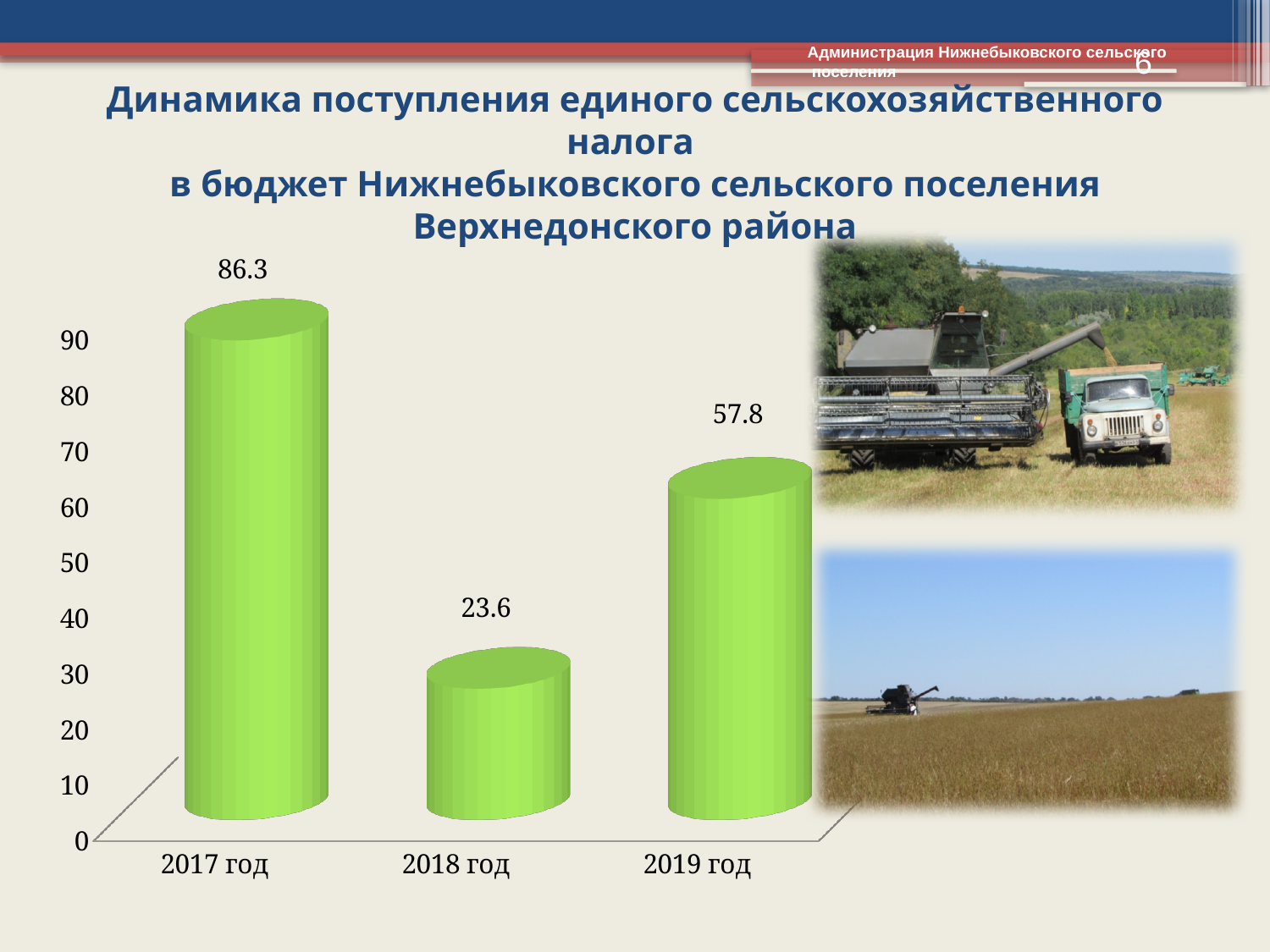
What kind of chart is shown on the slide? bar chart Which year has the highest value? 2017 год What is the value for 2019 год? 57.8 Which is larger, the value for 2019 год or the value for 2018 год? 2019 год What is the difference between the values for 2019 год and 2018 год? 34.2 Is the value for 2019 год greater or less than 50? greater What is the difference between the values for 2017 год and 2018 год? 62.7 Does the value rise or fall from 2018 год to 2019 год? rise What is the value for 2018 год? 23.6 What is the value for 2017 год? 86.3 Which year has the lowest value? 2018 год How many years are shown on the chart? 3